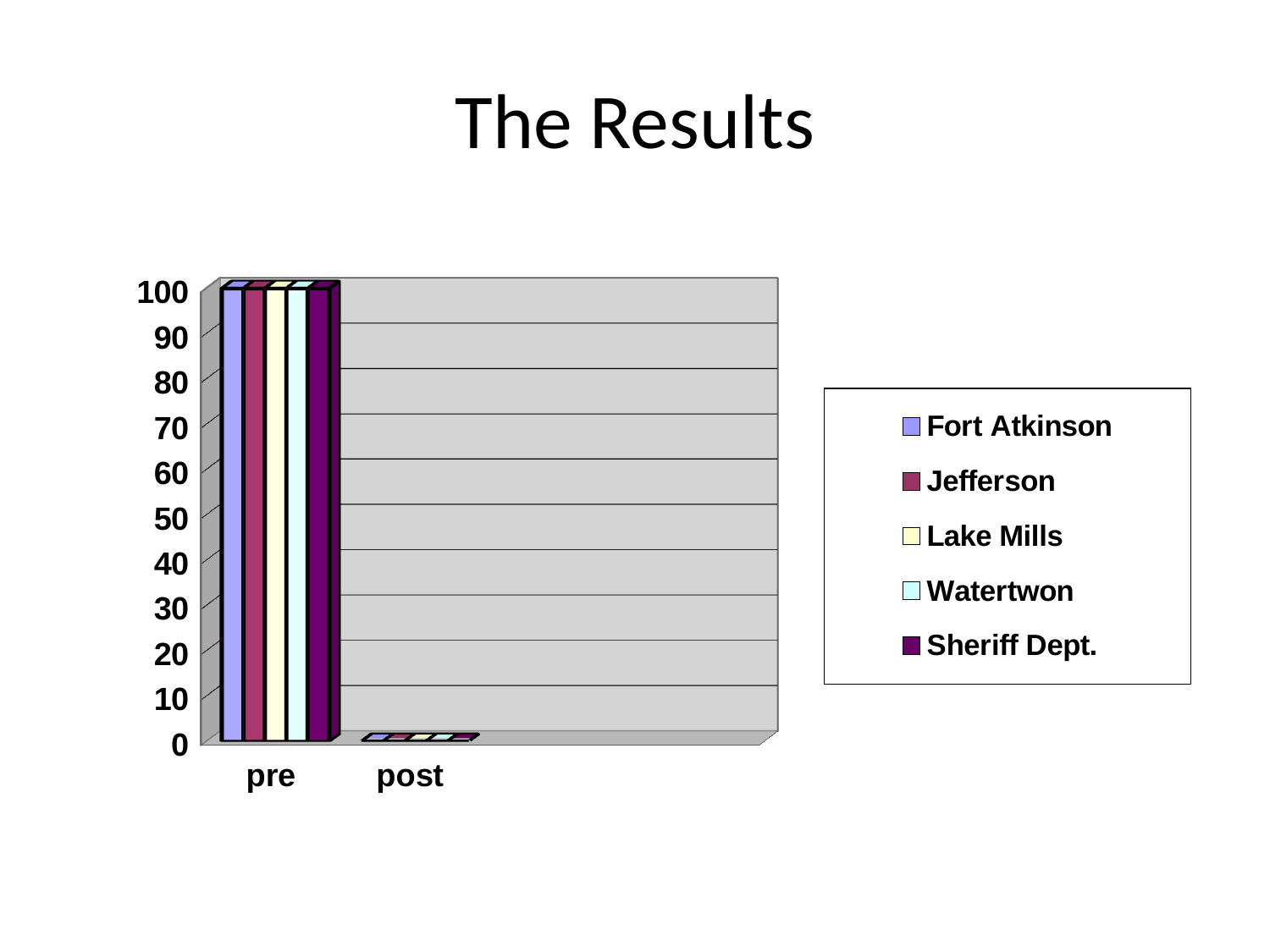
What is the value for Fort Atkinson in the pre category? 100 How many series does the legend list? 5 What is the title of the slide? The Results Is the value for Lake Mills in the pre category greater or less than 90? greater What is the value for Sheriff Dept. in the pre category? 100 Which series is listed last in the legend? Sheriff Dept. What kind of chart is shown on the slide? bar chart Do the values rise or fall from pre to post? fall How many categories are shown on the x axis? 2 Is the value for Watertwon in the post category greater or less than 20? less Which category has the higher values, pre or post? pre Is the value for Jefferson in the post category greater or less than 10? less